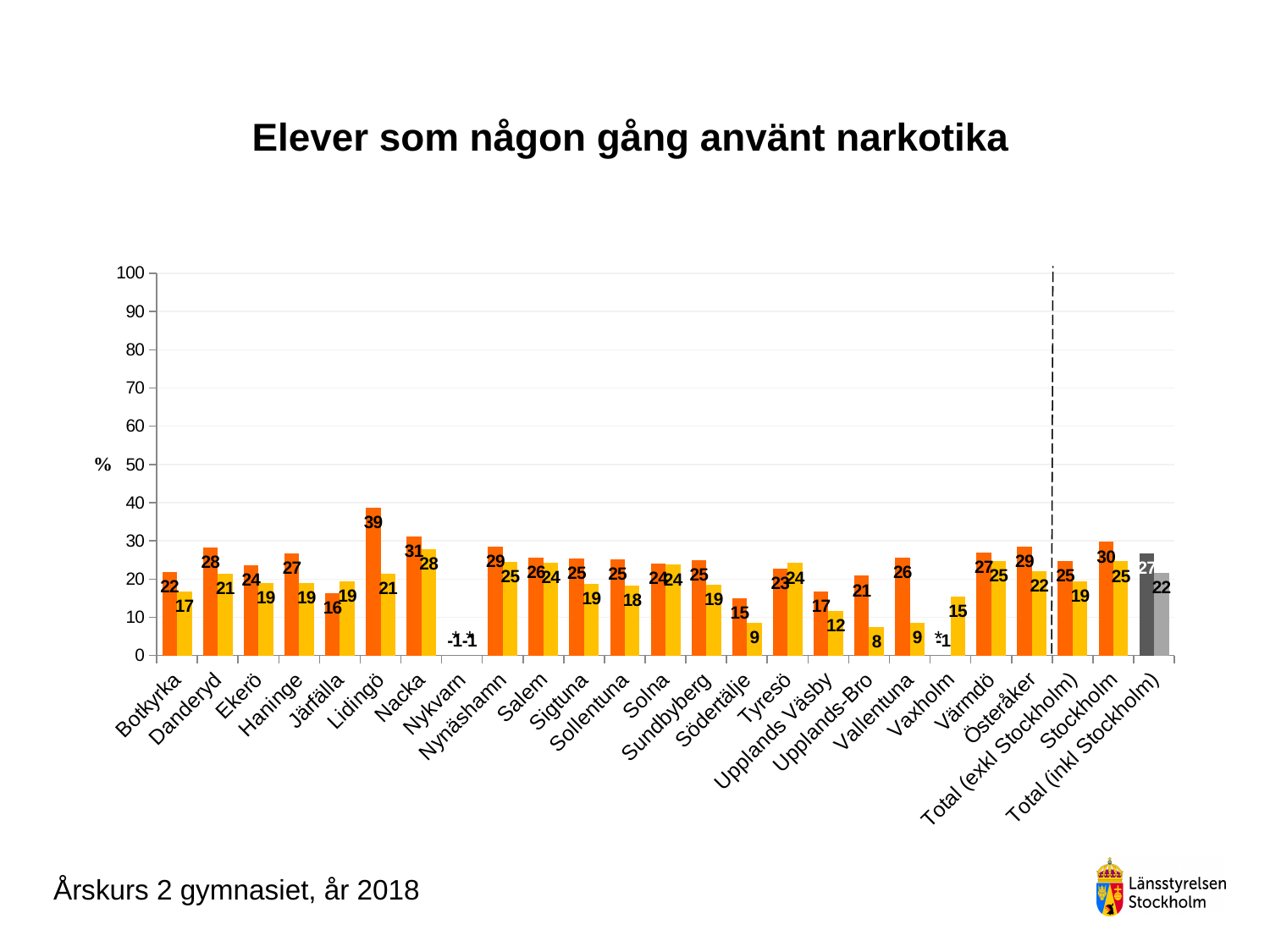
What is the difference between the orange and yellow bars for Lidingö? 18 What type of chart is shown on the slide? bar chart What is the value of the orange bar for Lidingö? 39 Which municipality has the highest orange bar? Lidingö What is the title of the chart? Elever som någon gång använt narkotika Which municipality has the lowest yellow bar? Upplands-Bro What is the value of the yellow bar for Nacka? 28 What is the value of the yellow bar for Upplands-Bro? 8 What is the value of the orange bar for Stockholm? 30 Is the orange bar for Lidingö greater or less than 30? greater Which is larger for Järfälla, the orange bar or the yellow bar? the yellow bar What is the difference between the orange bars for Stockholm and Total (exkl Stockholm)? 5